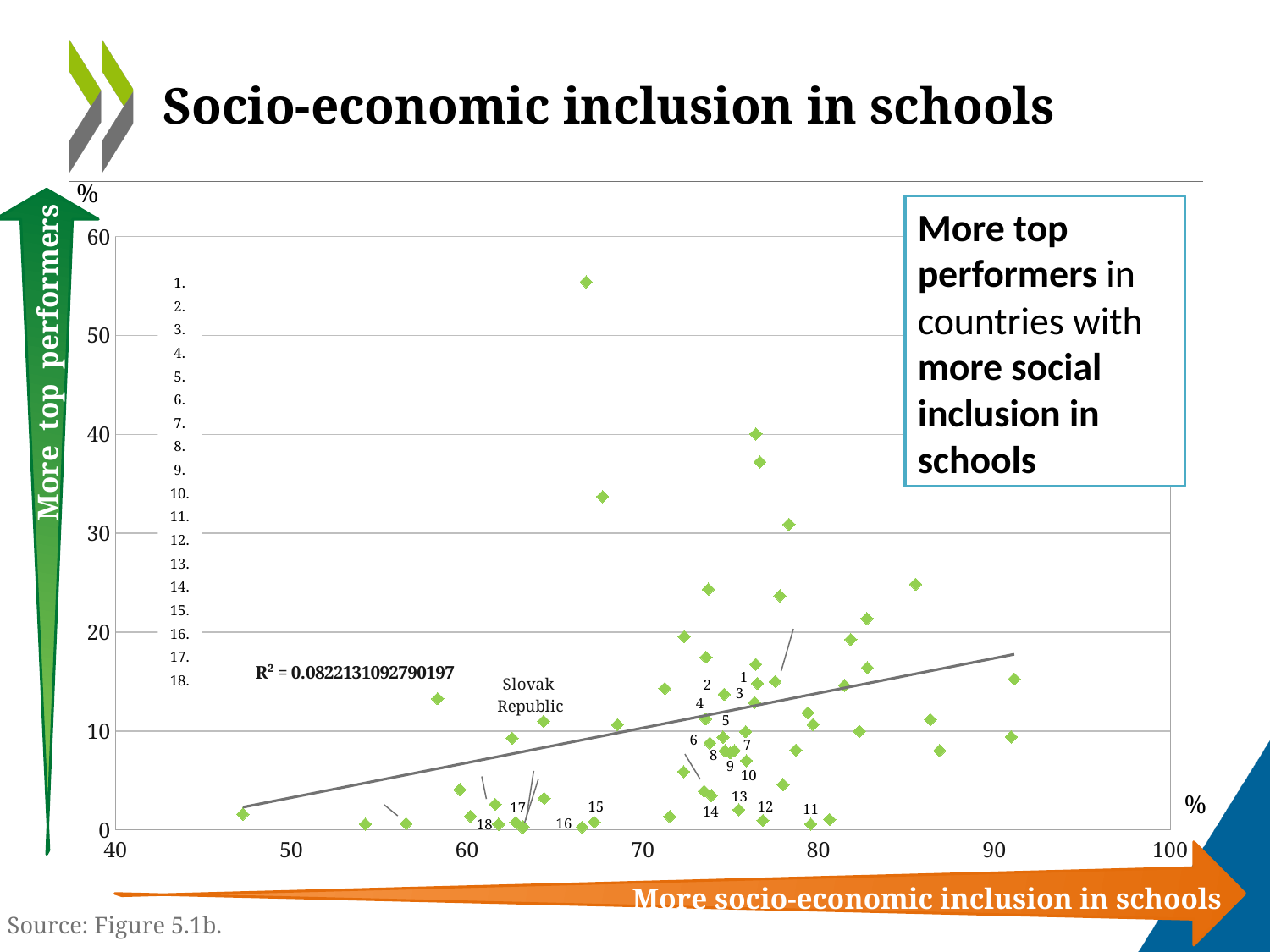
Is the percentage of top performers for the highest point on the chart greater or less than 50? greater Does the fitted trend line rise or fall as socio-economic inclusion increases along the x axis? rises What kind of chart is shown on the slide? scatter chart Is the socio-economic inclusion value (x axis) for the Slovak Republic greater or less than 60? greater How many numbered data points are labelled on the chart? 18 What R² value is printed on the chart? R² = 0.0822131092790197 Is the percentage of top performers for point 1 greater or less than 10? greater What is the title of the slide's chart? Socio-economic inclusion in schools Which has a higher percentage of top performers, point 1 or point 14? point 1